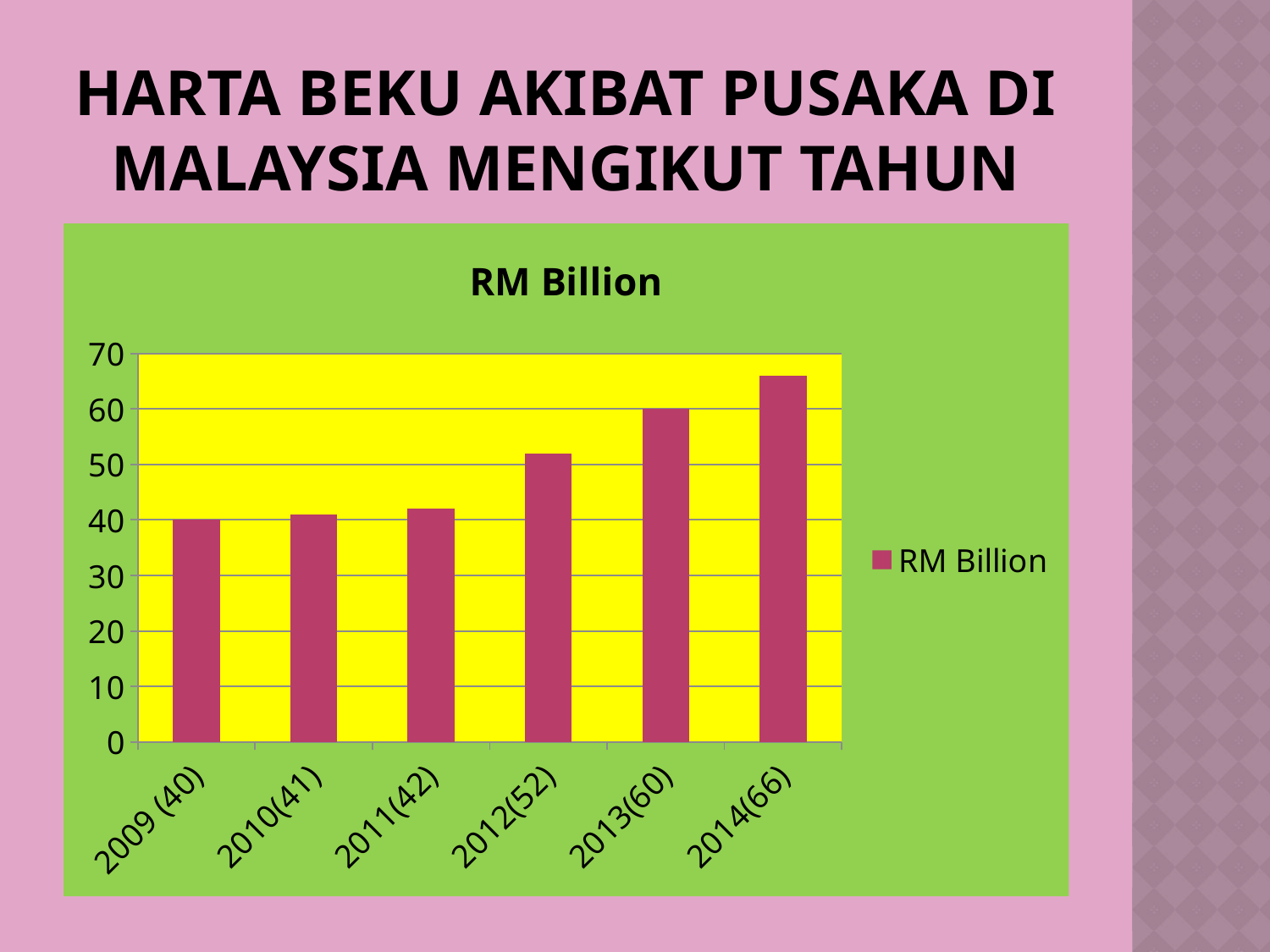
How many series does the legend list? 1 Which year has the lowest value? 2009 What is the value for 2012 according to the category label? 52 What is the difference between the values for 2014 and 2009? 26 What is the value for 2014 according to the category label? 66 How many bars (years) are plotted in the chart? 6 What is the title of the chart? RM Billion What kind of chart is shown on the slide? bar chart Which year has the highest value? 2014 What is the value for 2009 according to the category label? 40 Which is larger, the value for 2013 or the value for 2011? 2013 Do the values rise or fall from 2009 to 2014? rise